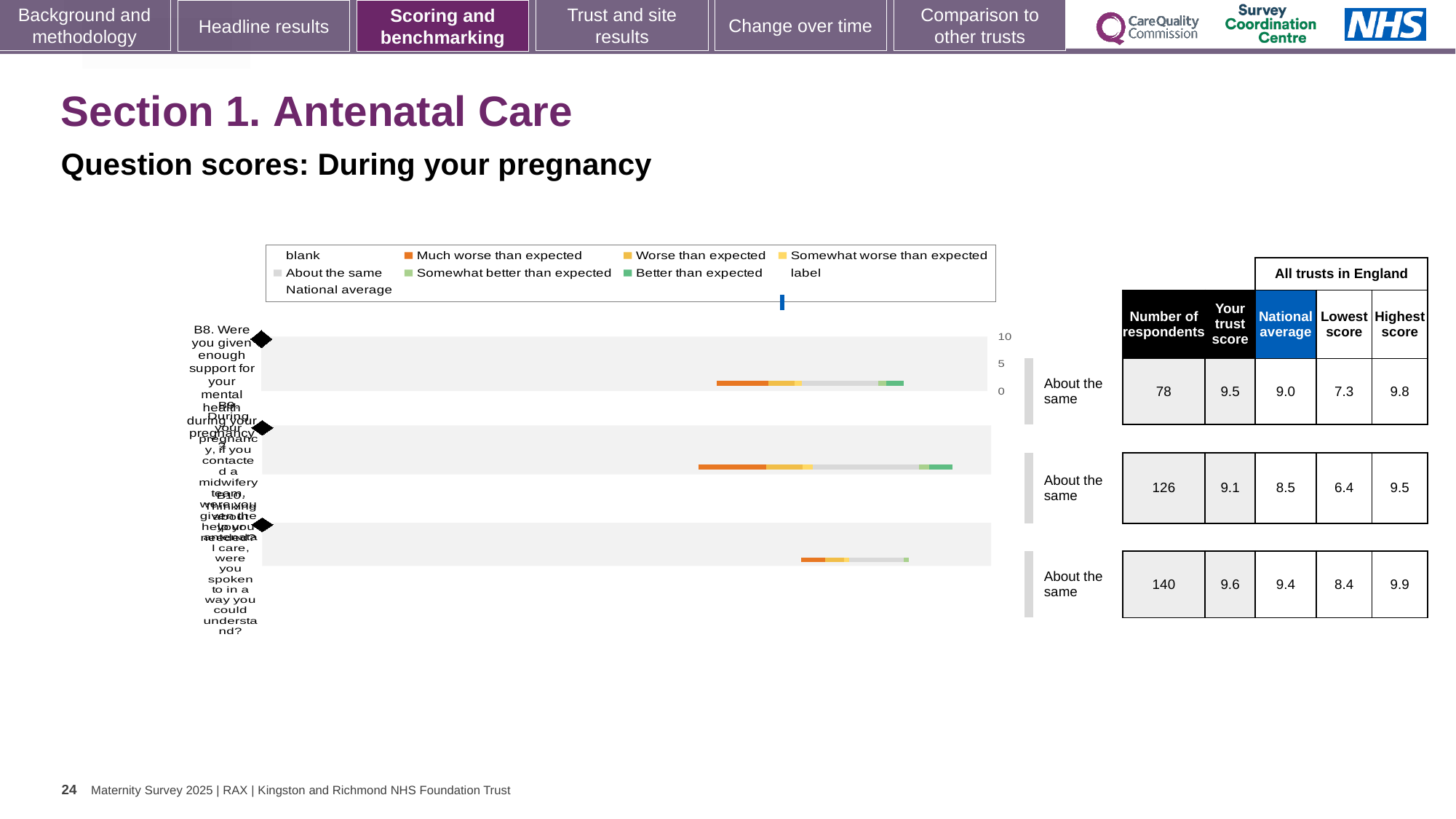
What benchmark category is shown for question B8? About the same For question B8, which is larger: the trust score or the national average? the trust score (9.5) What is the difference between the highest score and the lowest score for question B8? 2.5 What is the subtitle describing the chart on this slide? Question scores: During your pregnancy What is the lowest score in England for the second (middle) row of the chart? 6.4 What is the number of respondents for question B8 (support for your mental health during your pregnancy)? 78 Which row of the chart has the lowest national average? the second (middle) row, with 8.5 What is the trust score for question B8 (support for your mental health during your pregnancy)? 9.5 What kind of chart is shown on the slide? bar chart What is the national average for question B8 (support for your mental health during your pregnancy)? 9.0 How many question rows are plotted in the chart? 3 Which row of the chart has the highest number of respondents? the third (bottom) row, with 140